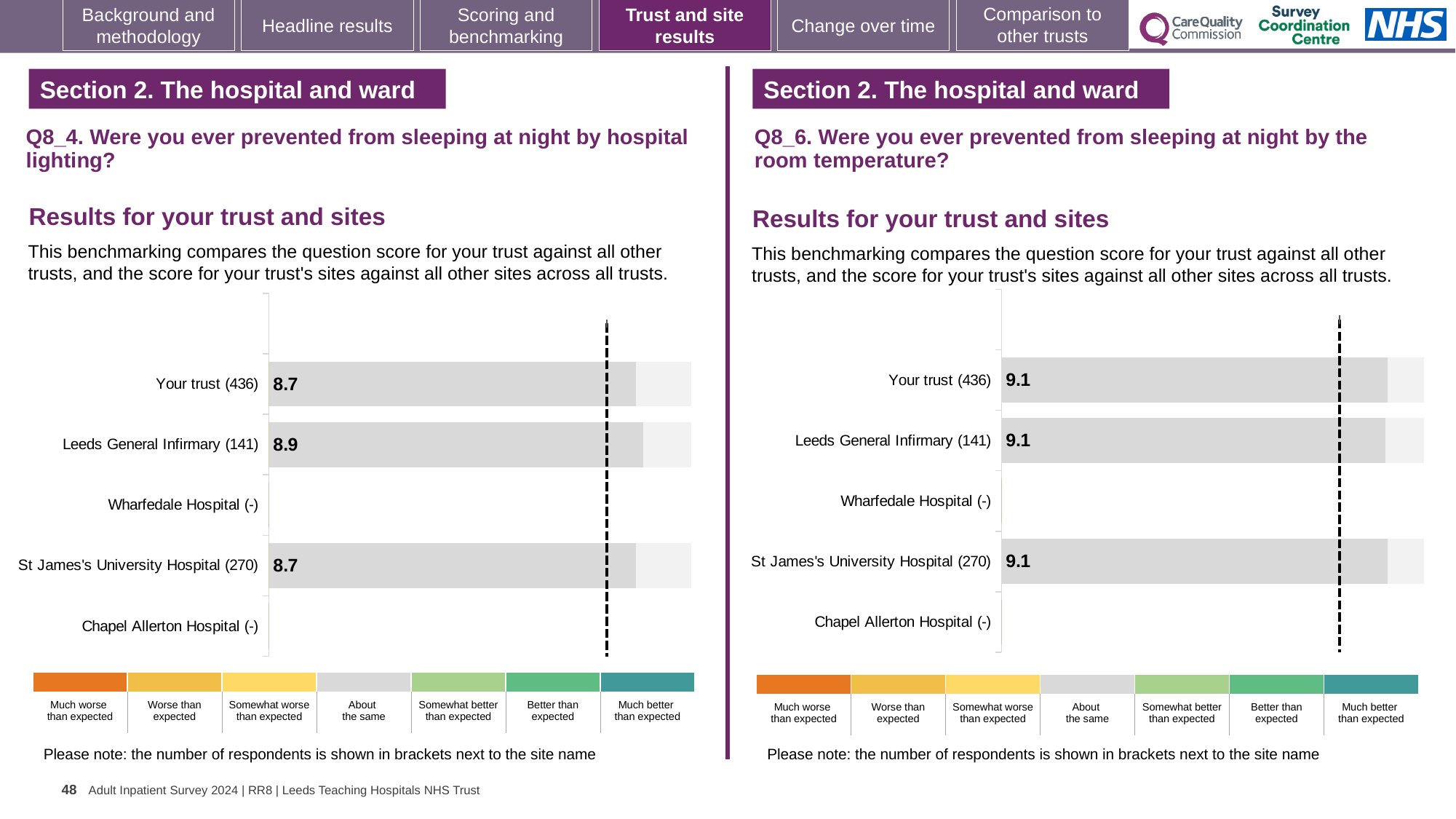
How many benchmark categories does the colour legend below the Q8_4 hospital lighting chart show? 7 How many site rows are listed in the Q8_4 hospital lighting chart? 5 In the Q8_4 hospital lighting chart, what is the score for St James's University Hospital (270)? 8.7 In the Q8_6 room temperature chart, what is the score for St James's University Hospital (270)? 9.1 In the Q8_4 hospital lighting chart, what is the score for Leeds General Infirmary (141)? 8.9 In the Q8_6 room temperature chart, what is the difference between the scores for Your trust (436) and Leeds General Infirmary (141)? 0 In the Q8_4 hospital lighting chart, which site has the highest score? Leeds General Infirmary (141) In the Q8_4 hospital lighting chart, what is the score for Your trust (436)? 8.7 In the Q8_6 room temperature chart, what is the score for Your trust (436)? 9.1 What kind of chart is used for the Q8_6 room temperature results? Bar chart In the Q8_4 hospital lighting chart, what is the difference between the scores for Leeds General Infirmary (141) and St James's University Hospital (270)? 0.2 In the Q8_4 hospital lighting chart, which has the larger score, Your trust (436) or Leeds General Infirmary (141)? Leeds General Infirmary (141)